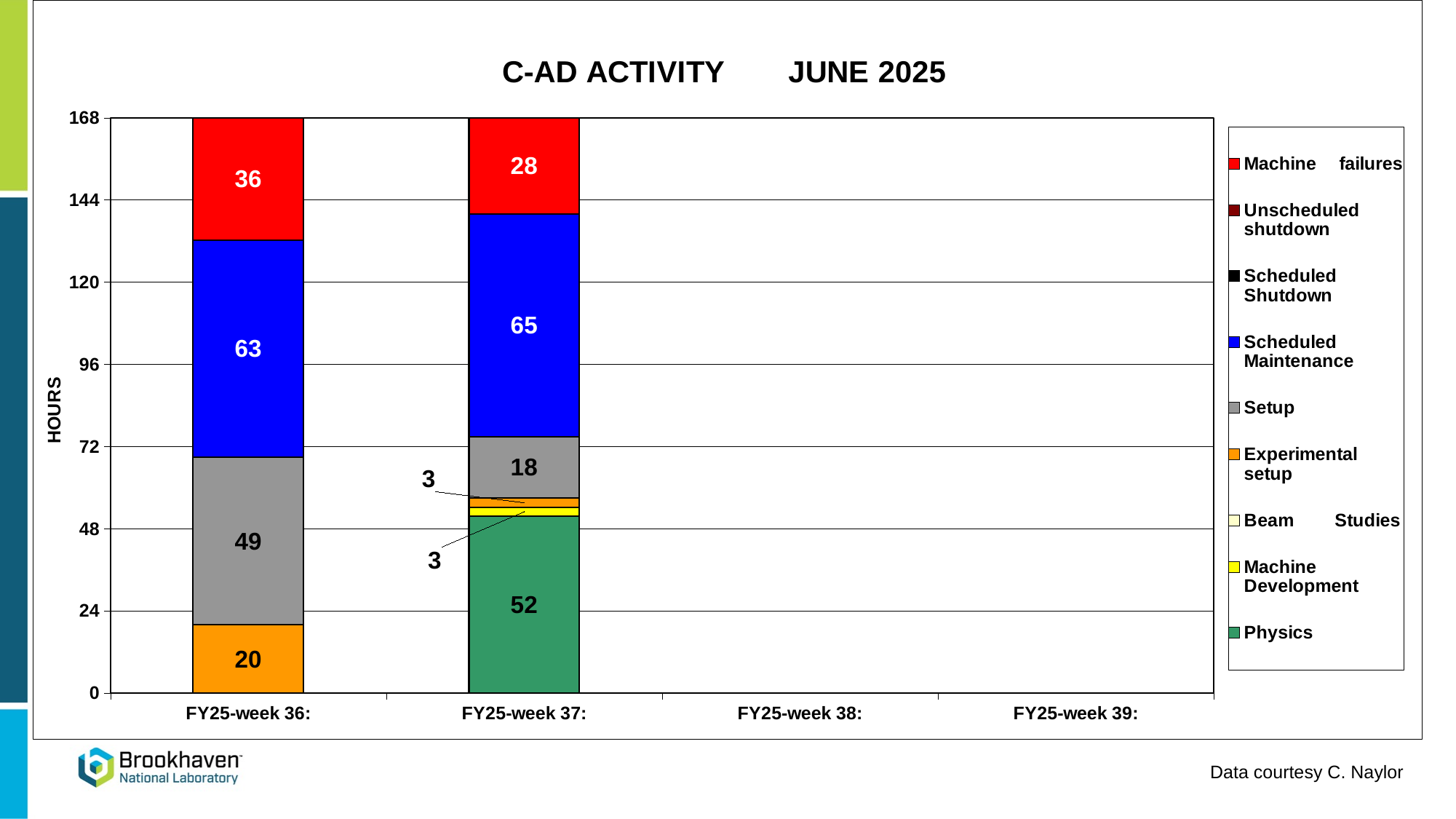
How many series does the legend list? 9 How many categories are shown on the x axis? 4 What is the value for Scheduled Maintenance in FY25-week 37? 65 What is the total of the stacked bar for FY25-week 36? 168 What is the value for Machine failures in FY25-week 36? 36 What kind of chart is shown? Stacked bar chart What is the value for Setup in FY25-week 36? 49 What is the value for Physics in FY25-week 37? 52 What is the title of the chart? C-AD ACTIVITY JUNE 2025 What is the value for Experimental setup in FY25-week 36? 20 What is the difference between Machine failures in FY25-week 36 and FY25-week 37? 8 Which is larger: Setup in FY25-week 36 or Setup in FY25-week 37? FY25-week 36